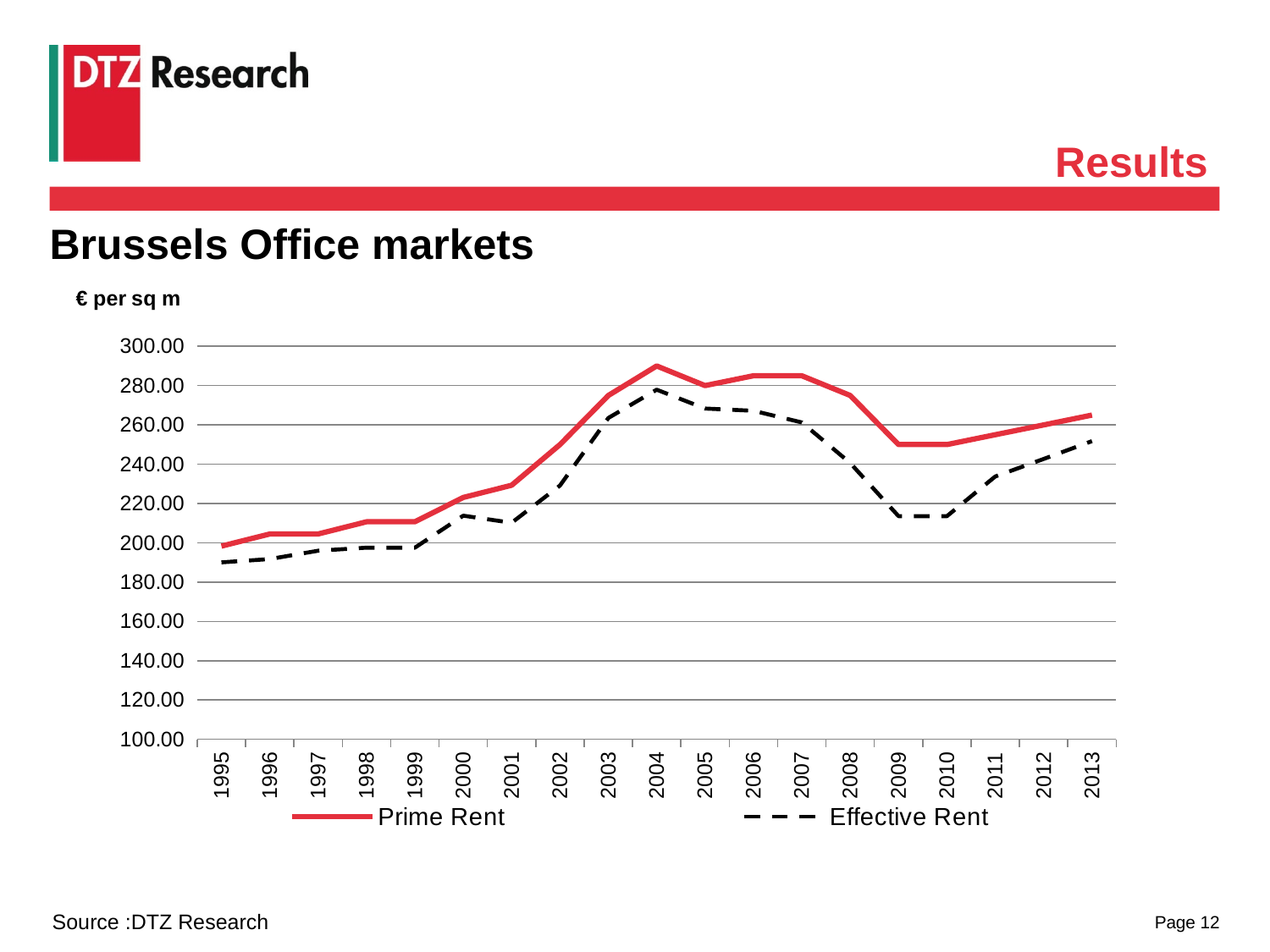
What kind of chart is shown on the slide? line chart In which year is Prime Rent at its lowest? 1995 How many years are plotted along the x axis? 19 In which year does Prime Rent reach its highest value? 2004 In which year does Effective Rent reach its highest value? 2004 Is the Prime Rent value for 2004 greater or less than 280.00? greater Which is higher in 2009, Prime Rent or Effective Rent? Prime Rent Is the Effective Rent value for 1995 greater or less than 200.00? less Is the Effective Rent value for 2009 greater or less than 220.00? less Does Prime Rent rise or fall between 2004 and 2009? fall What unit is shown above the chart's y axis? € per sq m How many series does the legend list? 2